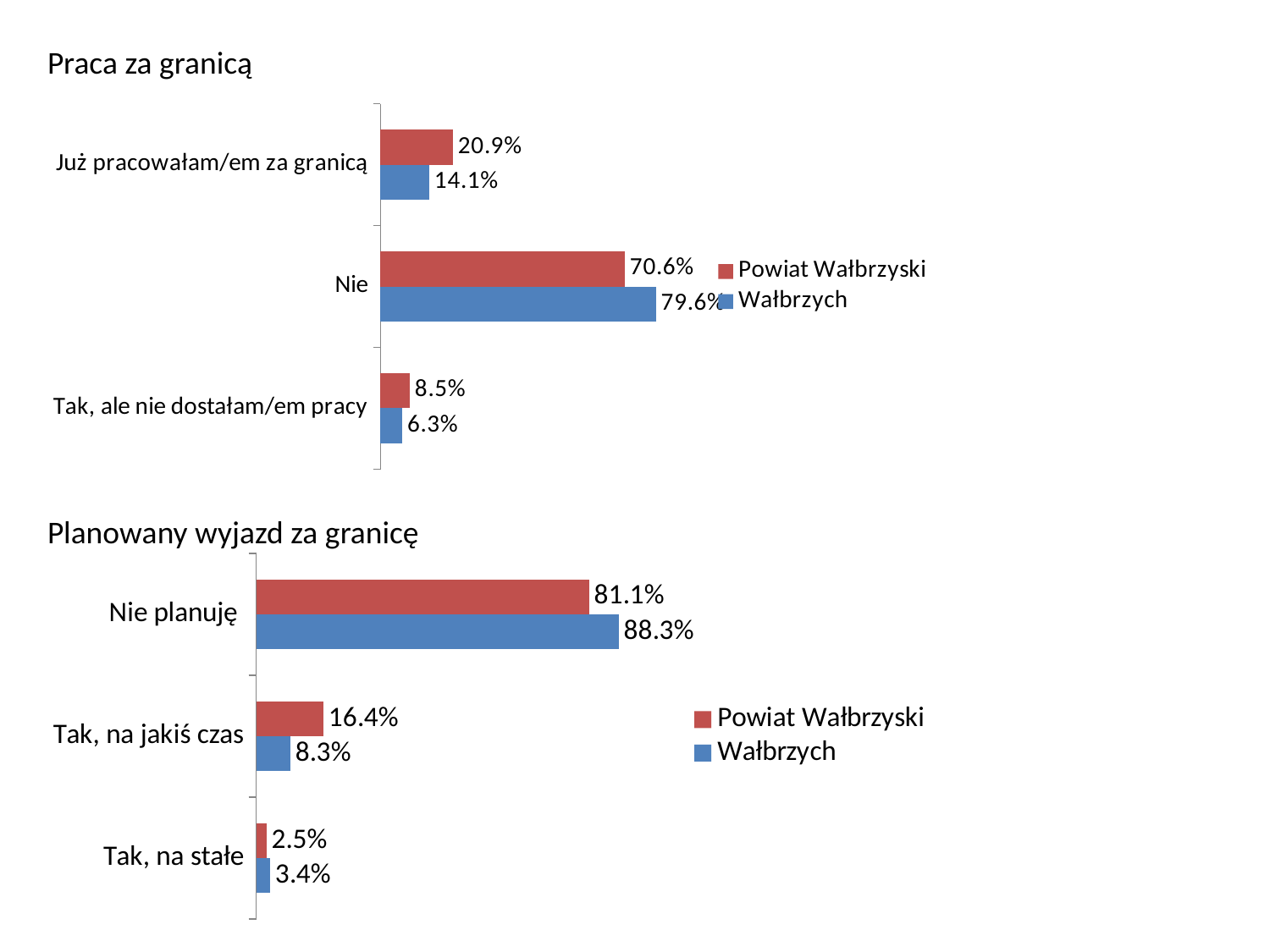
In the 'Praca za granicą' chart, which category has the lowest value for Wałbrzych? Tak, ale nie dostałam/em pracy In the 'Planowany wyjazd za granicę' chart, what is the difference between Powiat Wałbrzyski and Wałbrzych for 'Tak, na jakiś czas'? 8.1% How many categories does the 'Praca za granicą' chart show? 3 In the 'Praca za granicą' chart, what is the value for Wałbrzych for 'Nie'? 79.6% In the 'Planowany wyjazd za granicę' chart, what is the value for Wałbrzych for 'Nie planuję'? 88.3% What kind of chart is the 'Planowany wyjazd za granicę' chart? Bar chart In the 'Planowany wyjazd za granicę' chart, which category has the highest value for Powiat Wałbrzyski? Nie planuję In the 'Praca za granicą' chart, what is the value for Powiat Wałbrzyski for 'Już pracowałam/em za granicą'? 20.9% In the 'Planowany wyjazd za granicę' chart, what is the value for Powiat Wałbrzyski for 'Tak, na stałe'? 2.5% In the 'Praca za granicą' chart, what is the difference between Wałbrzych and Powiat Wałbrzyski for 'Nie'? 9.0% How many series does the legend of the 'Planowany wyjazd za granicę' chart list? 2 In the 'Praca za granicą' chart, which is larger for 'Tak, ale nie dostałam/em pracy': Powiat Wałbrzyski or Wałbrzych? Powiat Wałbrzyski